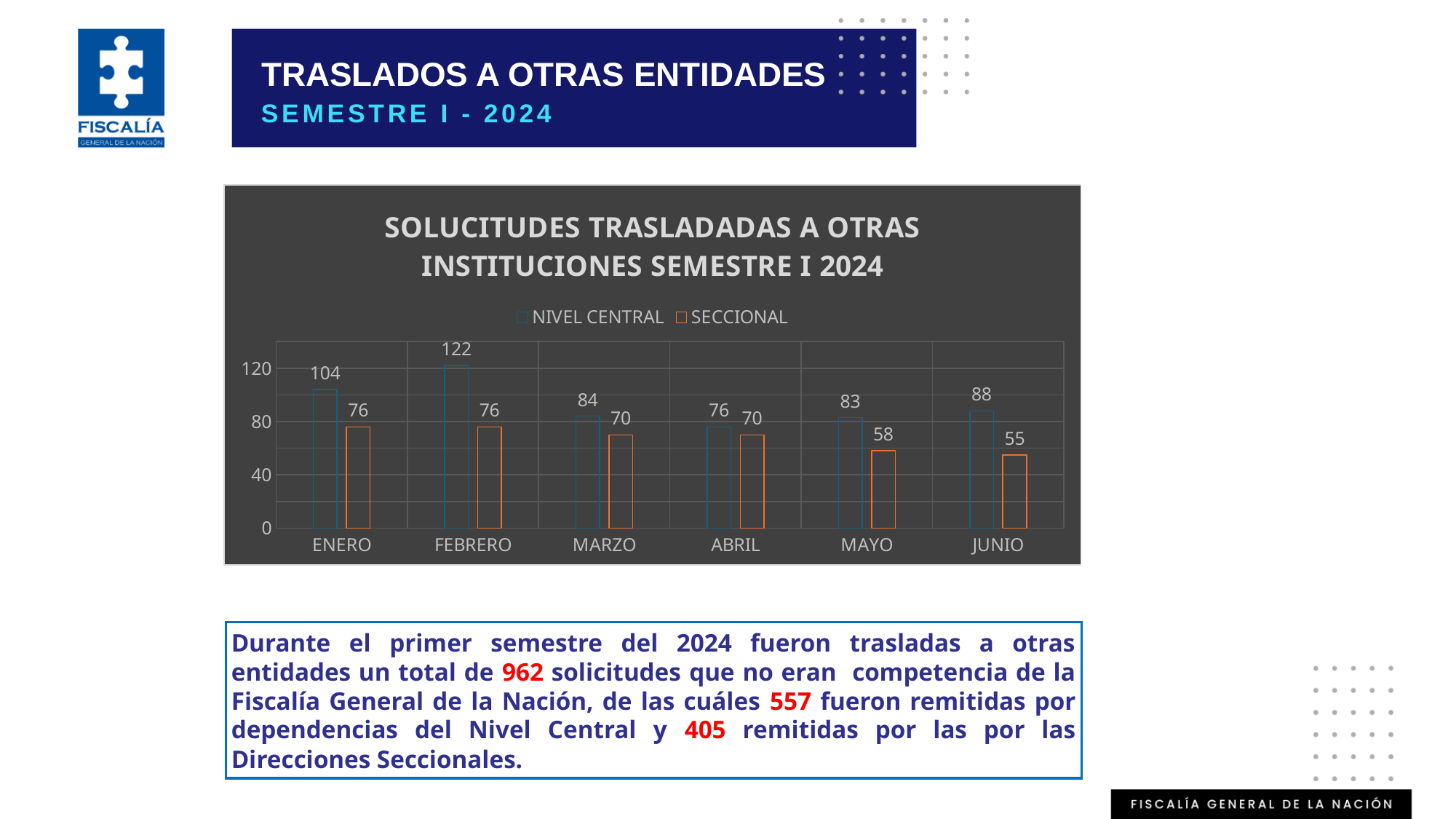
What is the NIVEL CENTRAL value for MAYO? 83 Which month has the lowest SECCIONAL value? JUNIO What is the difference between the NIVEL CENTRAL and SECCIONAL values in ENERO? 28 What is the NIVEL CENTRAL value for FEBRERO? 122 Which is larger in ABRIL, NIVEL CENTRAL or SECCIONAL? NIVEL CENTRAL How many series does the legend list? 2 Is the SECCIONAL value for MAYO greater or less than 80? less What kind of chart is shown on the slide? bar chart How many months are shown on the x axis? 6 Which month has the highest NIVEL CENTRAL value? FEBRERO Does the SECCIONAL series rise or fall from ABRIL to JUNIO? fall What is the SECCIONAL value for JUNIO? 55